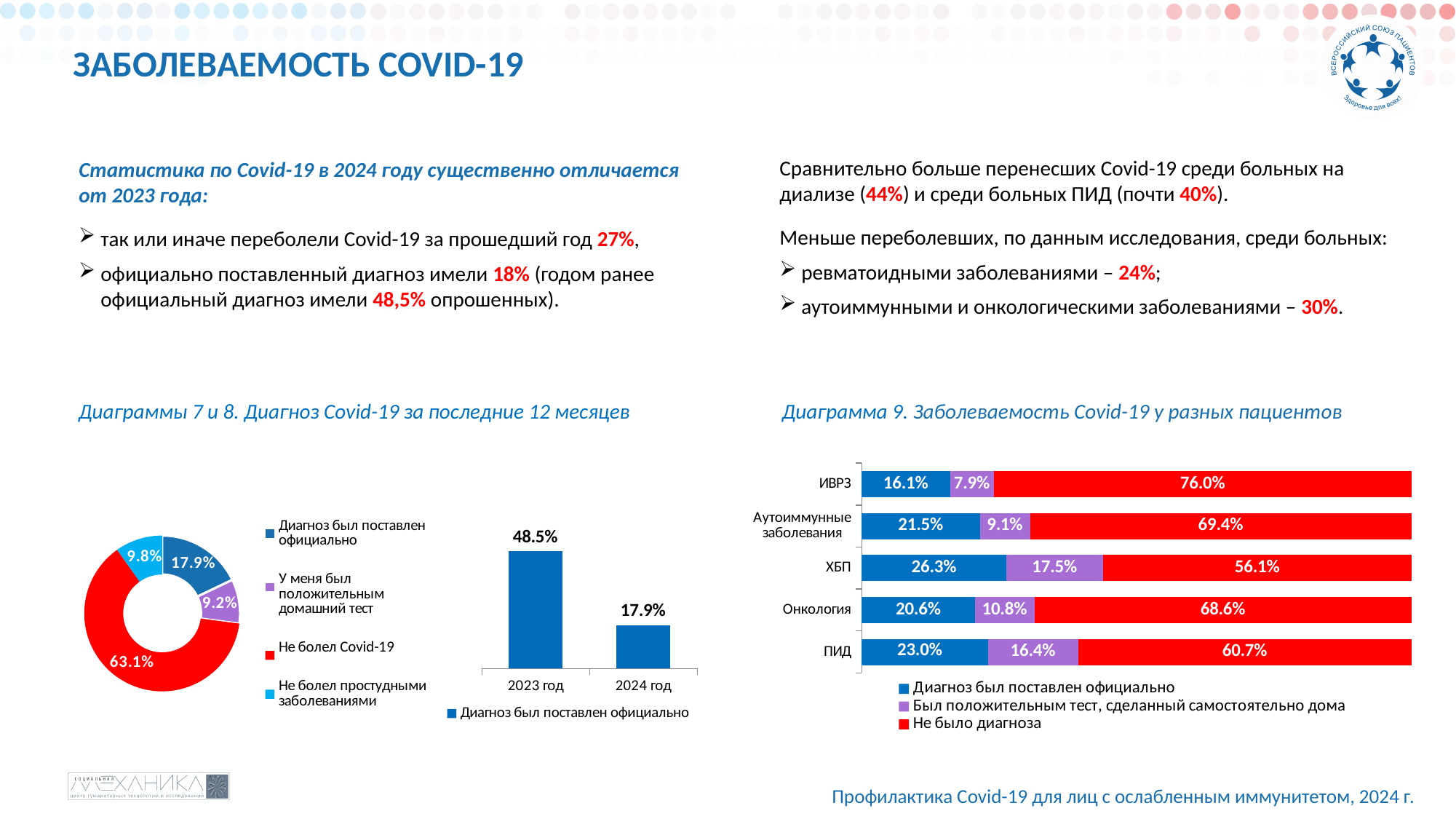
In Диаграмма 9, which patient group has the highest value for 'Был положительным тест, сделанный самостоятельно дома'? ХБП In Диаграмма 9, what is the value of 'Не было диагноза' for ИВРЗ? 76.0% In Диаграмма 9, which is larger: 'Не было диагноза' for Онкология or for ПИД? Онкология In Диаграмма 9, what is the value of 'Диагноз был поставлен официально' for ХБП? 26.3% What type of chart is the middle chart comparing 2023 год and 2024 год? Bar chart In the donut chart on the left, what share is labelled for 'Не болел Covid-19'? 63.1% How many patient groups are shown in Диаграмма 9? 5 In the donut chart on the left, what share is labelled for 'Диагноз был поставлен официально'? 17.9% In the bar chart in the middle, what is the difference between the 2023 год and 2024 год values? 30.6% In the donut chart on the left, which category has the smallest share? У меня был положительным домашний тест How many series does the legend of Диаграмма 9 list? 3 In the bar chart in the middle (2023 год vs 2024 год), what is the value for 2023 год? 48.5%